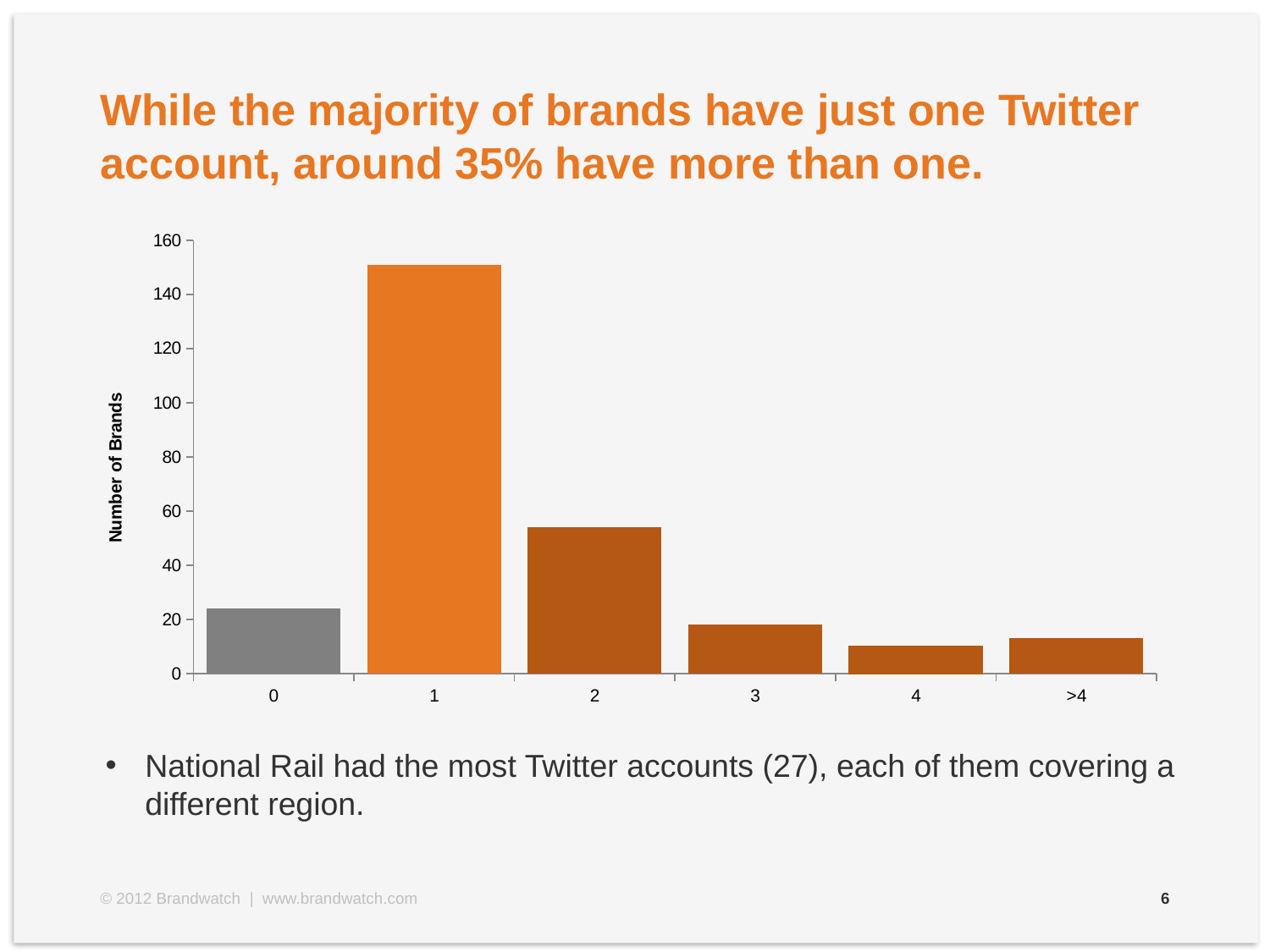
Which category has the highest number of brands? 1 What is the label of the vertical axis of the chart? Number of Brands Is the value for category 4 greater or less than 20? less Is the value for category 1 greater or less than 140? greater Which has more brands, category 0 or category 3? 0 Is the value for category 0 greater or less than 20? greater How many categories are shown on the x axis of the chart? 6 What kind of chart is shown on the slide? bar chart Which has more brands, category 2 or category >4? 2